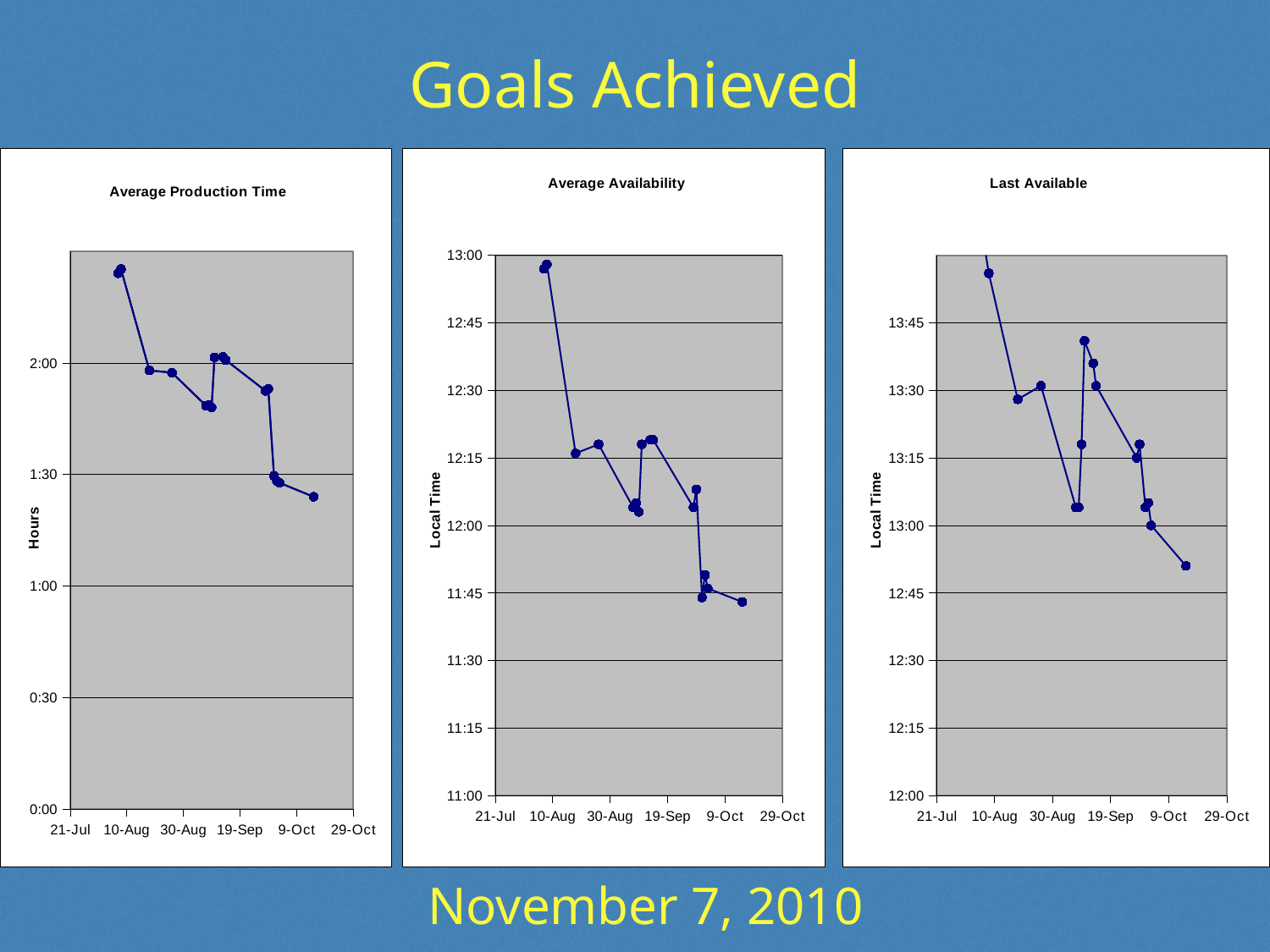
In the "Last Available" chart, is the first plotted value (around 10-Aug) greater or less than 13:45? greater In the "Average Production Time" chart, do the values generally rise or fall from left to right along the x axis? fall In the "Last Available" chart, is the last plotted value (mid-October) greater or less than 13:00? less What is the y-axis label of the "Average Production Time" chart? Hours In the "Average Availability" chart, is the last plotted value (mid-October) greater or less than 11:45? less What kind of chart is the "Average Production Time" chart? line chart In the "Average Availability" chart, do the values generally rise or fall over time? fall How many charts are shown on the slide? 3 In the "Last Available" chart, do the values generally rise or fall over time? fall